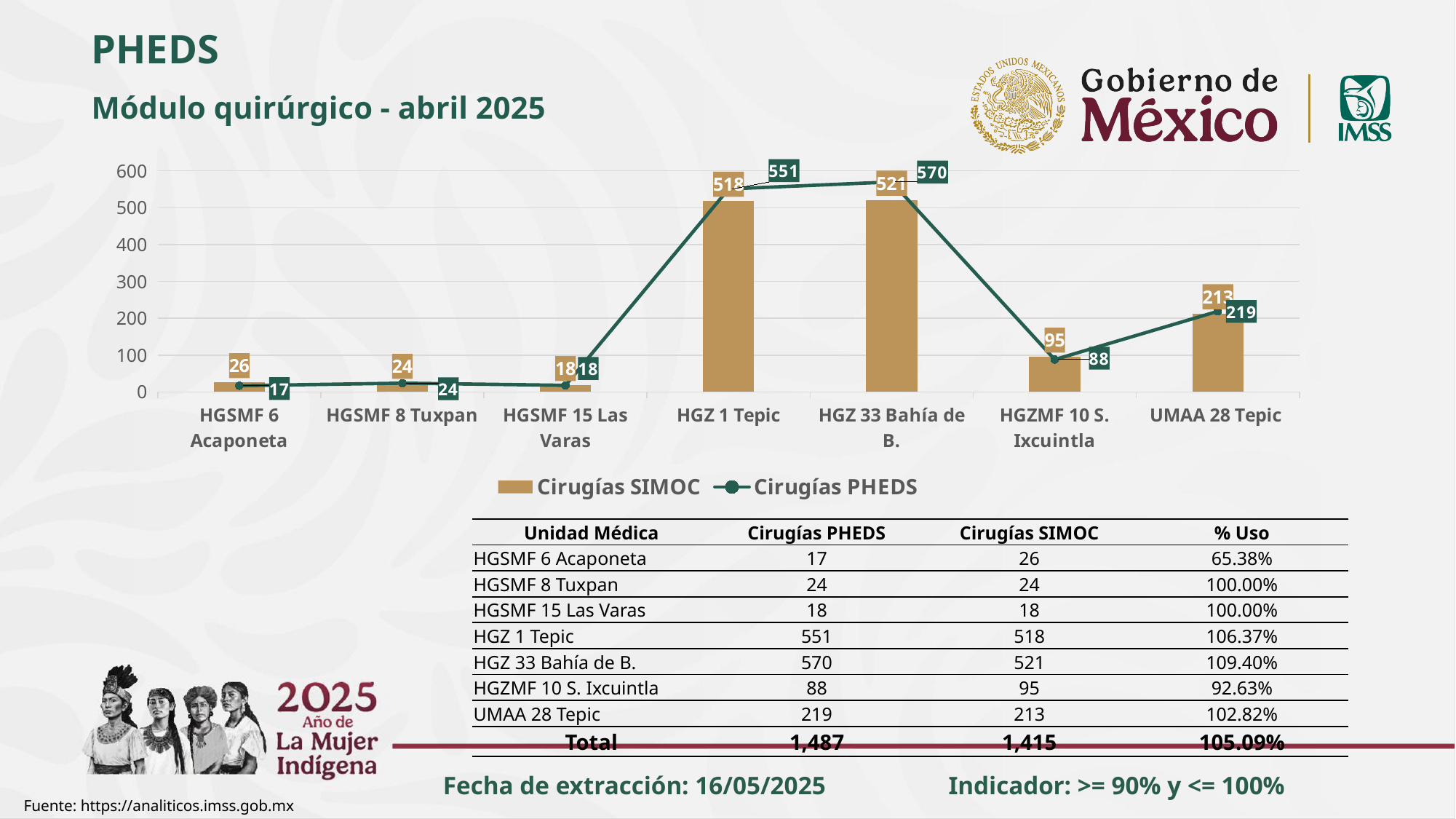
How many medical units are shown on the x axis of the chart? 7 How many series does the chart legend list? 2 What is the value of Cirugías PHEDS for HGZ 33 Bahía de B.? 570 Which unit has the lowest value of Cirugías PHEDS? HGSMF 6 Acaponeta What kind of chart is used to show Cirugías SIMOC? Bar chart What is the difference between Cirugías PHEDS and Cirugías SIMOC for HGZ 33 Bahía de B.? 49 Which unit has the highest value of Cirugías SIMOC? HGZ 33 Bahía de B. What is the value of Cirugías SIMOC for HGZ 1 Tepic? 518 What is the value of Cirugías PHEDS for HGZMF 10 S. Ixcuintla? 88 Which series is drawn as a line with markers in the chart? Cirugías PHEDS Is the value of Cirugías SIMOC for HGZ 1 Tepic greater or less than 500? greater For UMAA 28 Tepic, which is larger: Cirugías SIMOC or Cirugías PHEDS? Cirugías PHEDS